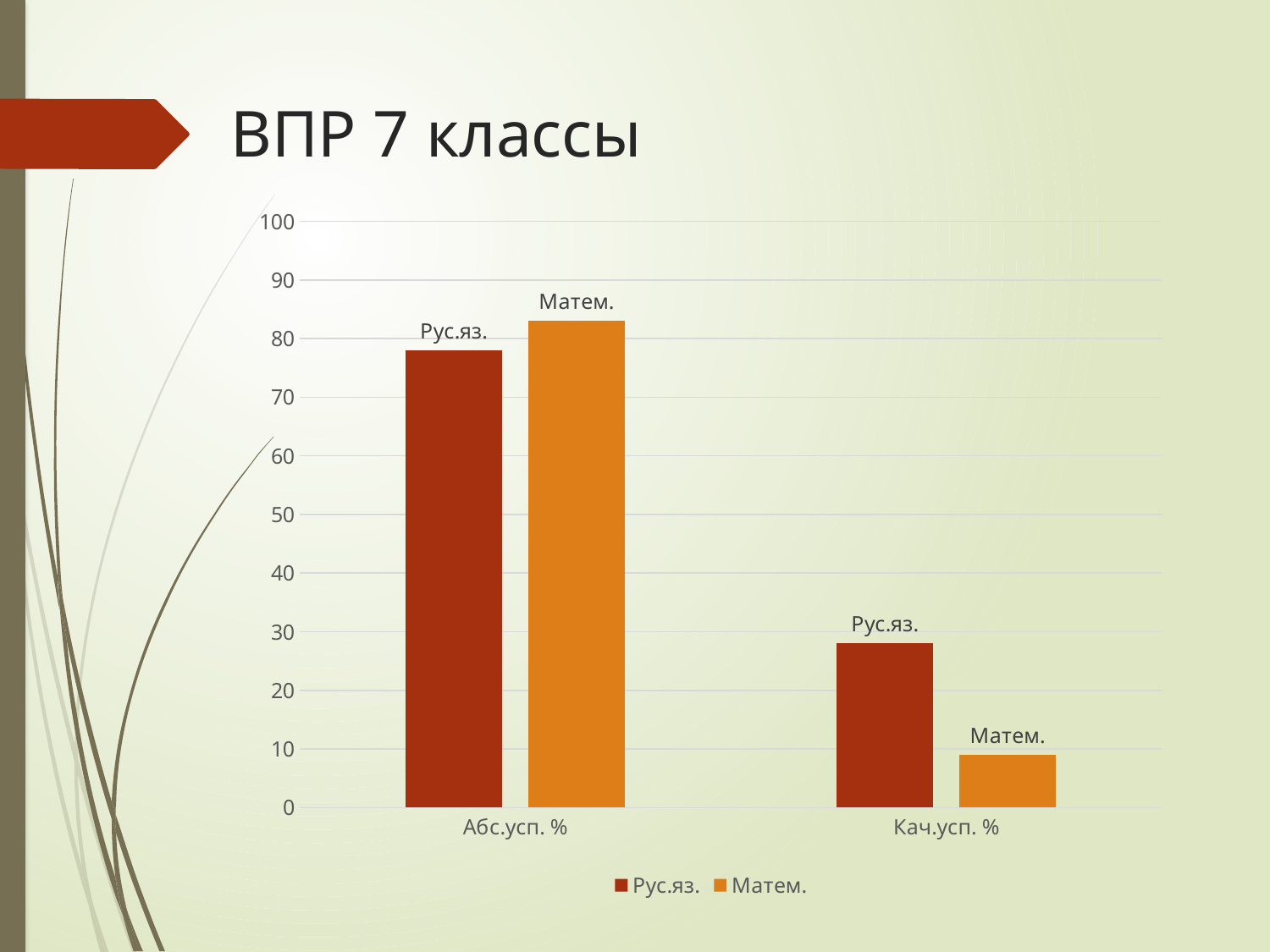
What is the title of the slide with the chart? ВПР 7 классы Which bar is the lowest in the chart? Матем. in Кач.усп. % How many series does the legend list? 2 Is the value for Рус.яз. in Абс.усп. % greater or less than 70? greater In the Абс.усп. % category, which series has the larger value, Рус.яз. or Матем.? Матем. What kind of chart is shown on the slide? bar chart Is the value for Матем. in Абс.усп. % greater or less than 80? greater Is the value for Рус.яз. in Кач.усп. % greater or less than 20? greater Which series is shown in orange in the legend? Матем. In the Кач.усп. % category, which series has the larger value, Рус.яз. or Матем.? Рус.яз. How many categories are shown on the x axis? 2